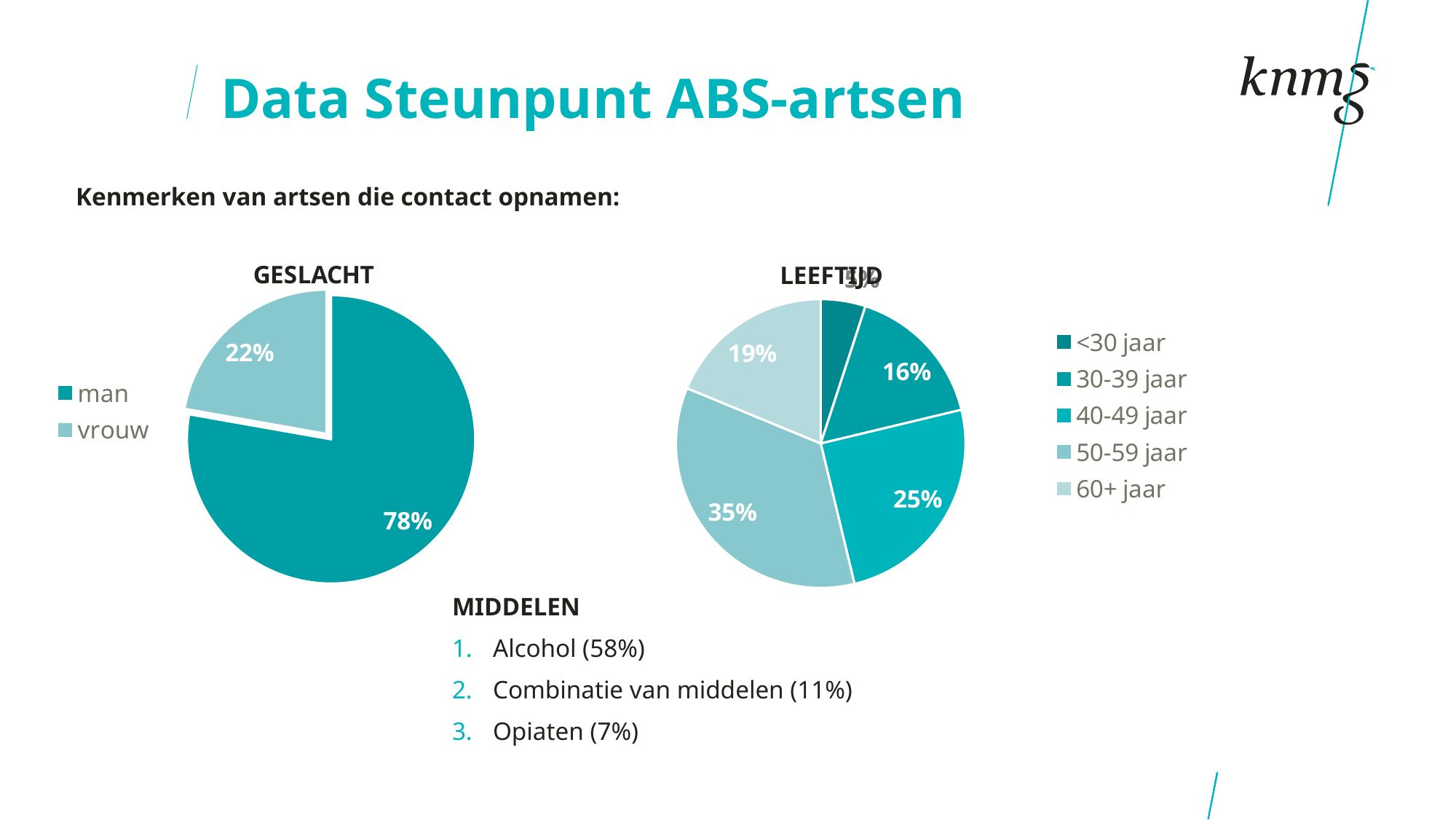
In the LEEFTIJD chart, what is the difference in percentage points between 50-59 jaar and 40-49 jaar? 10 In the GESLACHT chart, what percentage is shown for man? 78% In the GESLACHT chart, what percentage is shown for vrouw? 22% How many age groups does the legend of the LEEFTIJD chart list? 5 In the LEEFTIJD chart, what percentage is shown for 40-49 jaar? 25% In the LEEFTIJD chart, which age group has the smallest share? <30 jaar In the GESLACHT chart, what is the difference in percentage points between man and vrouw? 56 What kind of chart is the GESLACHT chart? pie chart In the LEEFTIJD chart, which is larger: 30-39 jaar or 60+ jaar? 60+ jaar In the LEEFTIJD chart, which age group has the largest share? 50-59 jaar In the LEEFTIJD chart, what percentage is shown for 60+ jaar? 19% In the LEEFTIJD chart, what percentage is shown for 50-59 jaar? 35%